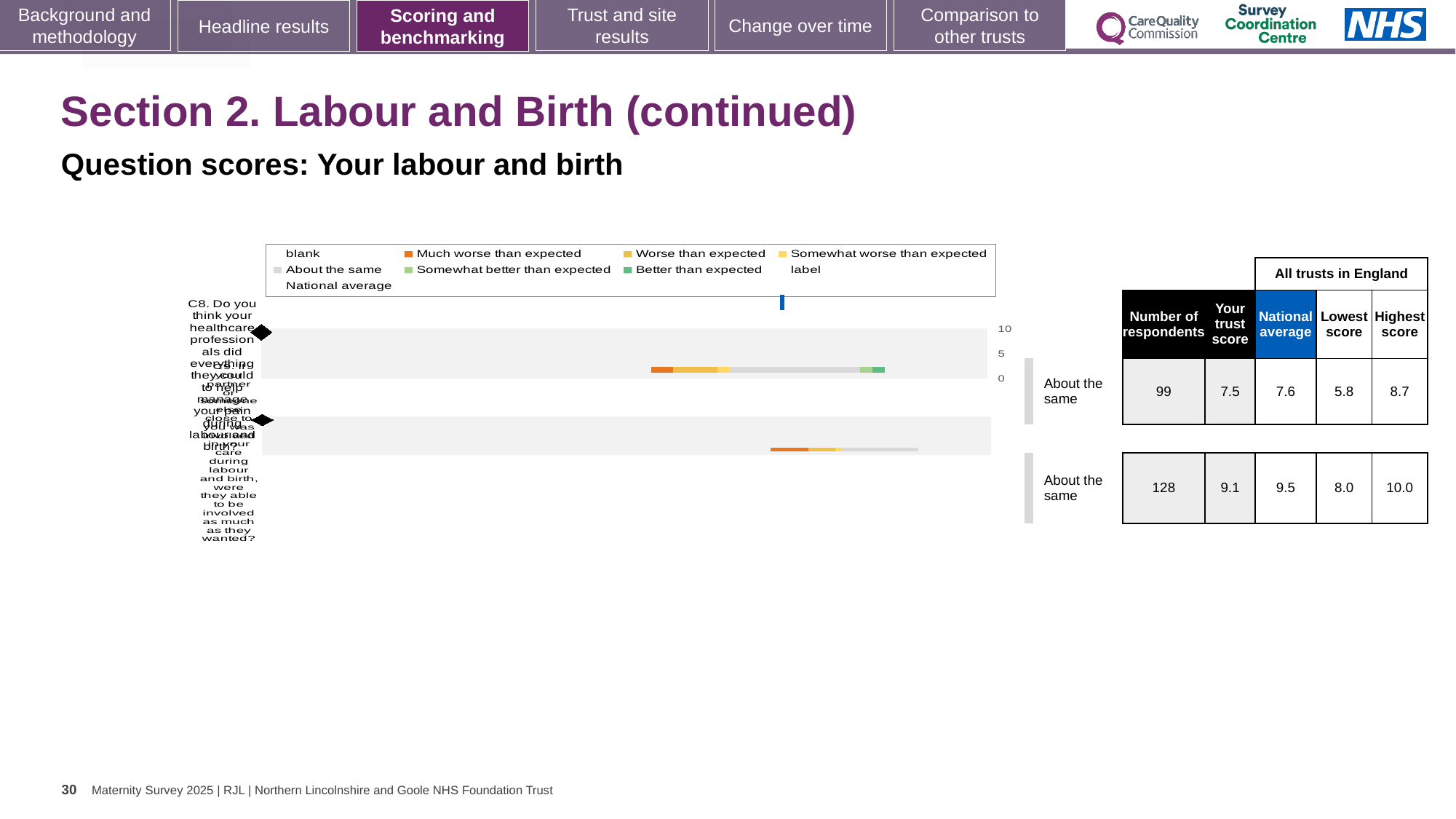
For the second bar, what is the difference between the national average and the trust score? 0.4 What colour is the 'Better than expected' legend entry in the chart? green What benchmark category is shown next to the first bar (question C8)? About the same How many question bars are plotted in the chart? 2 For the first bar (question C8), what is the difference between the highest score and the lowest score? 2.9 What is the number of respondents for the second bar? 128 What colour is the 'Much worse than expected' legend entry in the chart? orange What is the number of respondents for the first bar (question C8)? 99 What is the national average for the first bar (question C8)? 7.6 For the first bar (question C8), which is larger: the trust score or the national average? national average What kind of chart is shown on the slide? bar chart What is the trust score for the first bar (question C8)? 7.5